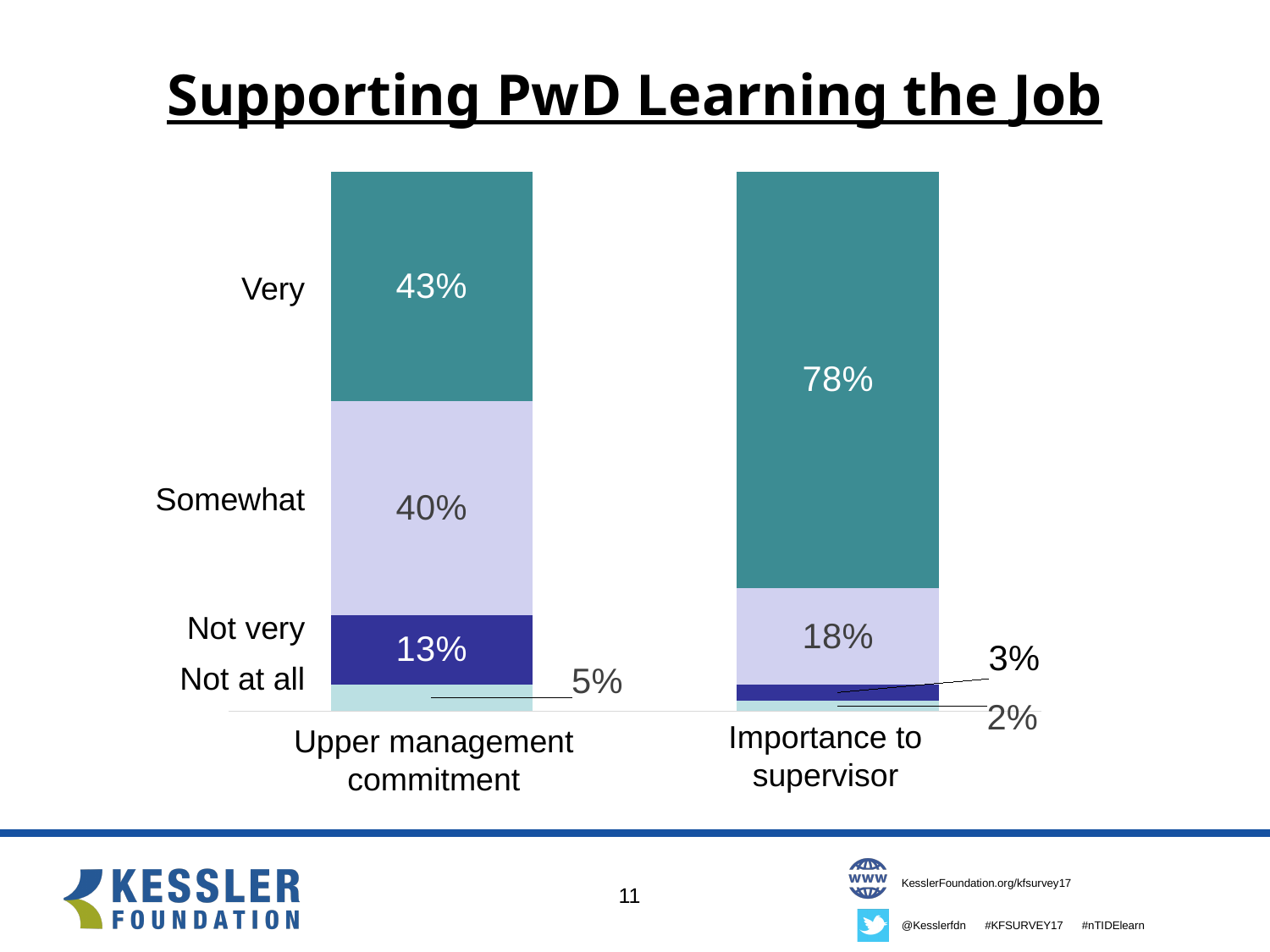
What is the "Somewhat" value for Upper management commitment? 40% What is the difference between the "Somewhat" values for Upper management commitment and Importance to supervisor? 22 percentage points How many bars (categories) are shown on the x axis? 2 What is the "Very" value for Importance to supervisor? 78% What type of chart is shown on the slide? Stacked bar chart Which response level is the smallest segment in the Importance to supervisor bar? Not at all What percentage of respondents rated upper management commitment as "Very" important? 43% What is the "Not at all" value for Upper management commitment? 5% Which category has the larger "Very" share, Upper management commitment or Importance to supervisor? Importance to supervisor How many response levels (series) are stacked in each bar? 4 What is the "Not very" value for Importance to supervisor? 3% What is the difference between the "Very" values for Importance to supervisor and Upper management commitment? 35 percentage points